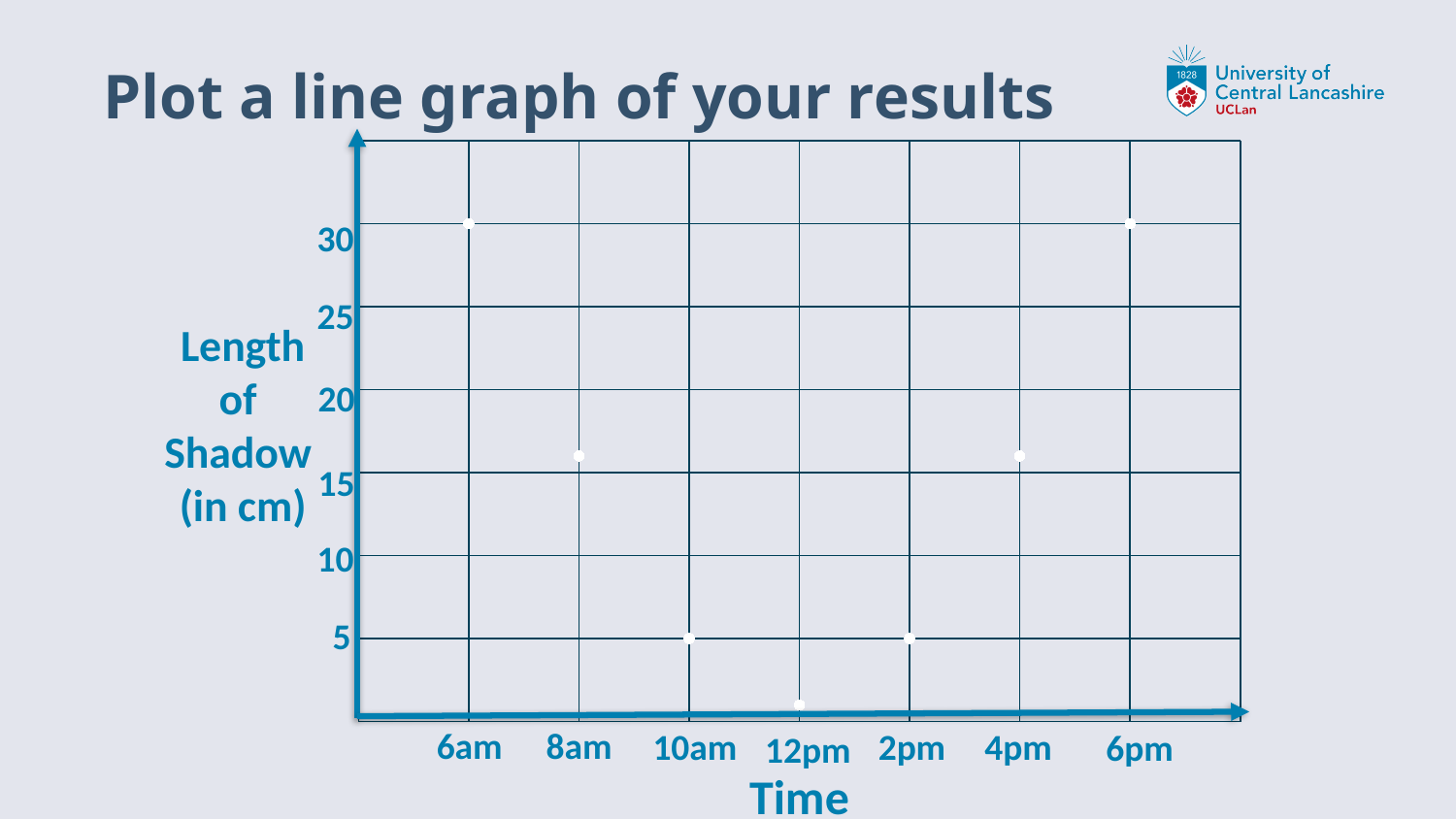
What is the length of shadow plotted at 10am? 5 What is the difference between the value at 6am and the value at 10am? 25 Do the plotted values rise or fall from 6am to 12pm? fall Is the value plotted at 4pm greater or less than 15? greater How many time points are plotted on the graph? 7 Is the value plotted at 8am greater or less than 20? less What is the length of shadow plotted at 6pm? 30 What is the label on the vertical axis? Length of Shadow (in cm) At which time is the plotted shadow length lowest? 12pm What is the length of shadow plotted at 2pm? 5 Which is larger, the value at 6am or the value at 10am? 6am What is the length of shadow plotted at 6am? 30